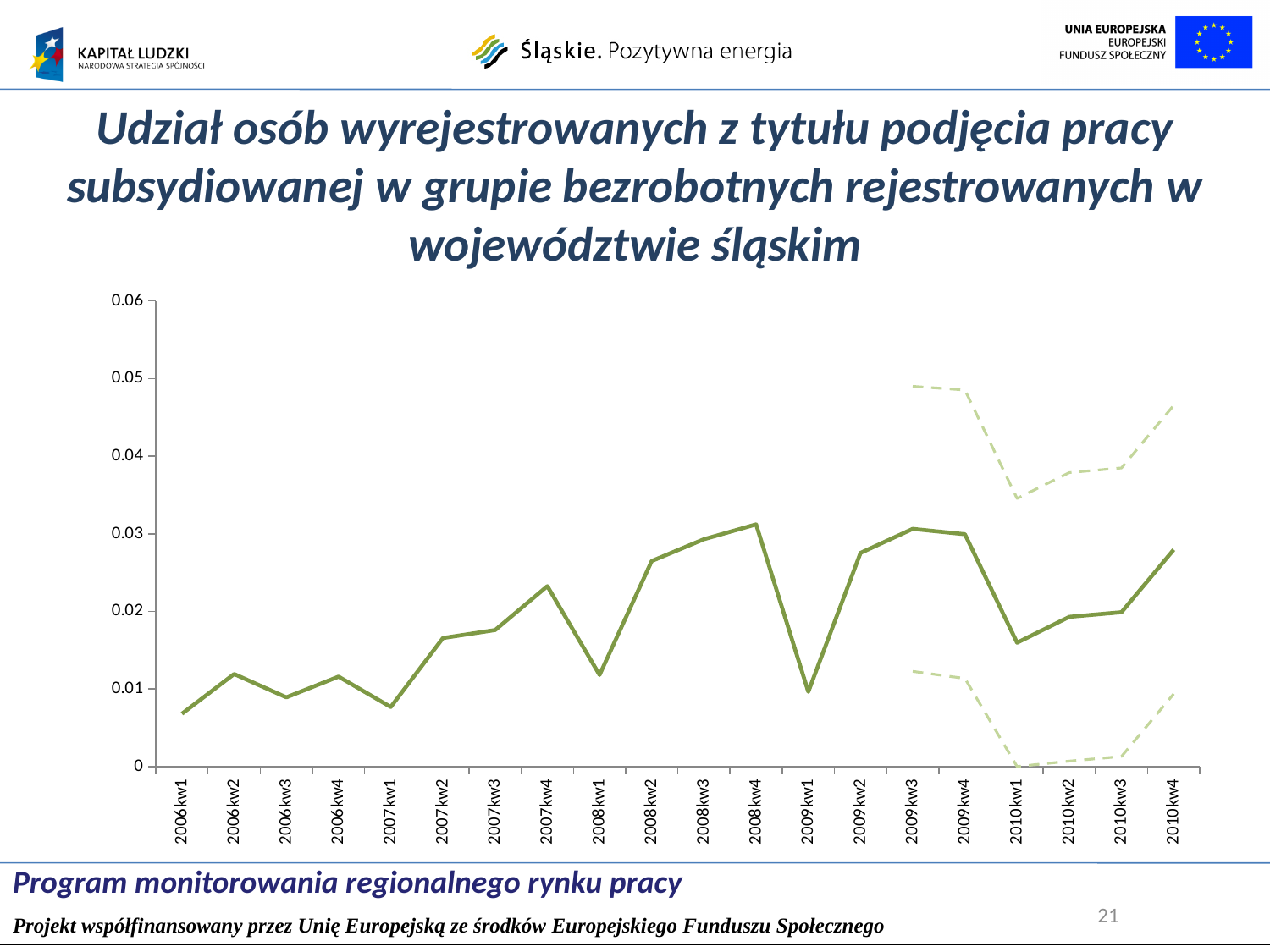
How many quarters (categories) are shown on the x axis? 20 What is the highest value shown on the y axis? 0.06 Is the value of the solid line for 2010kw1 greater or less than 0.02? less What kind of chart is shown on the slide? line chart Is the value of the solid line for 2009kw2 greater or less than 0.02? greater Does the solid line rise or fall from 2009kw4 to 2010kw1? fall From which quarter onward do the dashed lines appear on the chart? 2009kw3 Which has the larger value on the solid line, 2008kw1 or 2008kw2? 2008kw2 Is the value of the solid line for 2006kw1 greater or less than 0.01? less